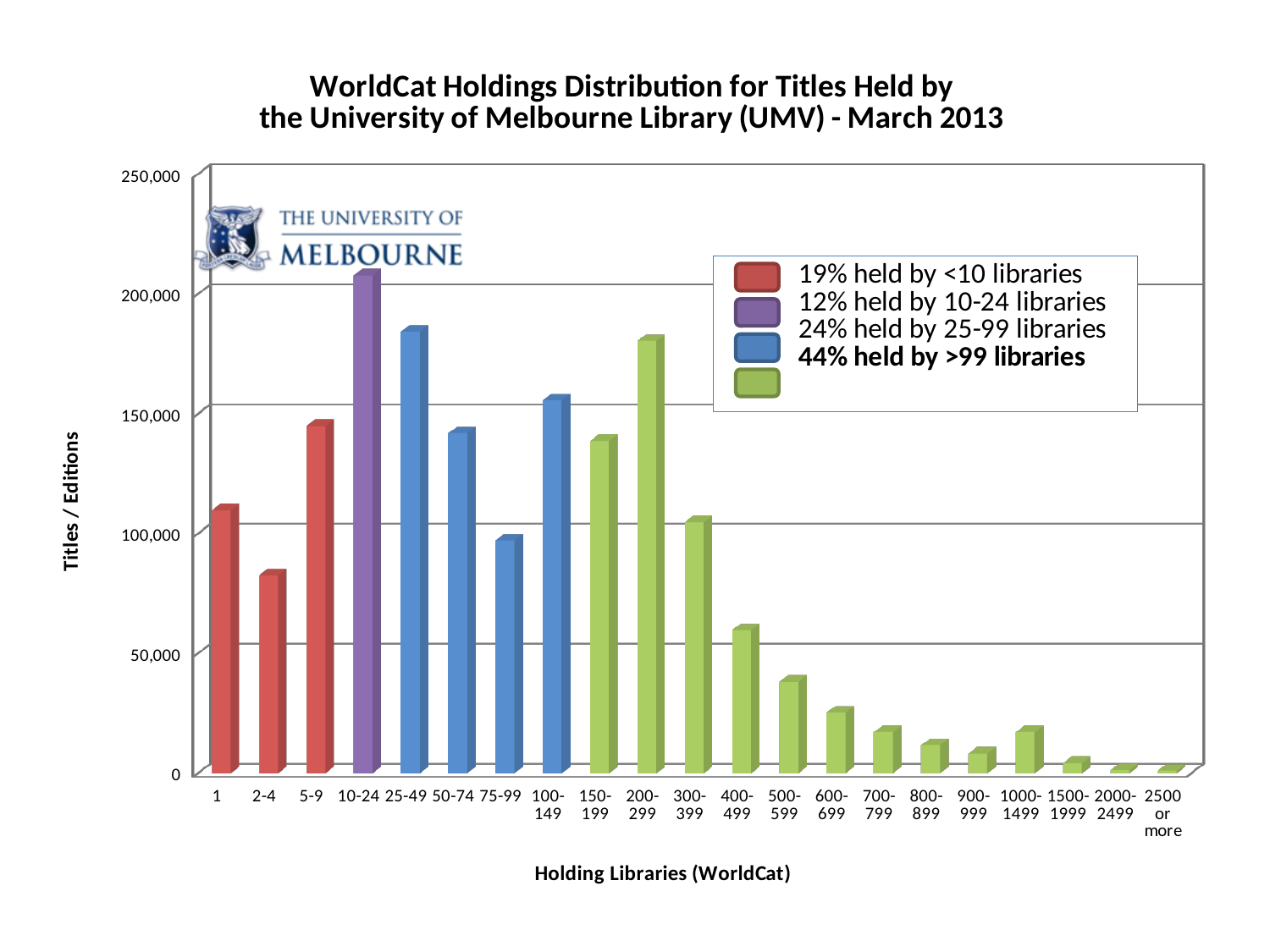
What is the title of the x axis? Holding Libraries (WorldCat) Is the value for the 10-24 category greater or less than 200,000? greater Which holding-libraries category has the highest number of titles / editions? 10-24 Is the value for the 500-599 category greater or less than 50,000? less Which has more titles / editions: the 5-9 category or the 2-4 category? 5-9 How many holding-libraries categories are shown on the x axis? 21 Which has more titles / editions: the 200-299 category or the 150-199 category? 200-299 What kind of chart is shown on the slide? bar chart Is the value for the 2-4 category greater or less than 100,000? less According to the legend, what percentage of titles is held by more than 99 libraries? 44% Moving along the x axis from the 300-399 category to the 900-999 category, do the values rise or fall? fall